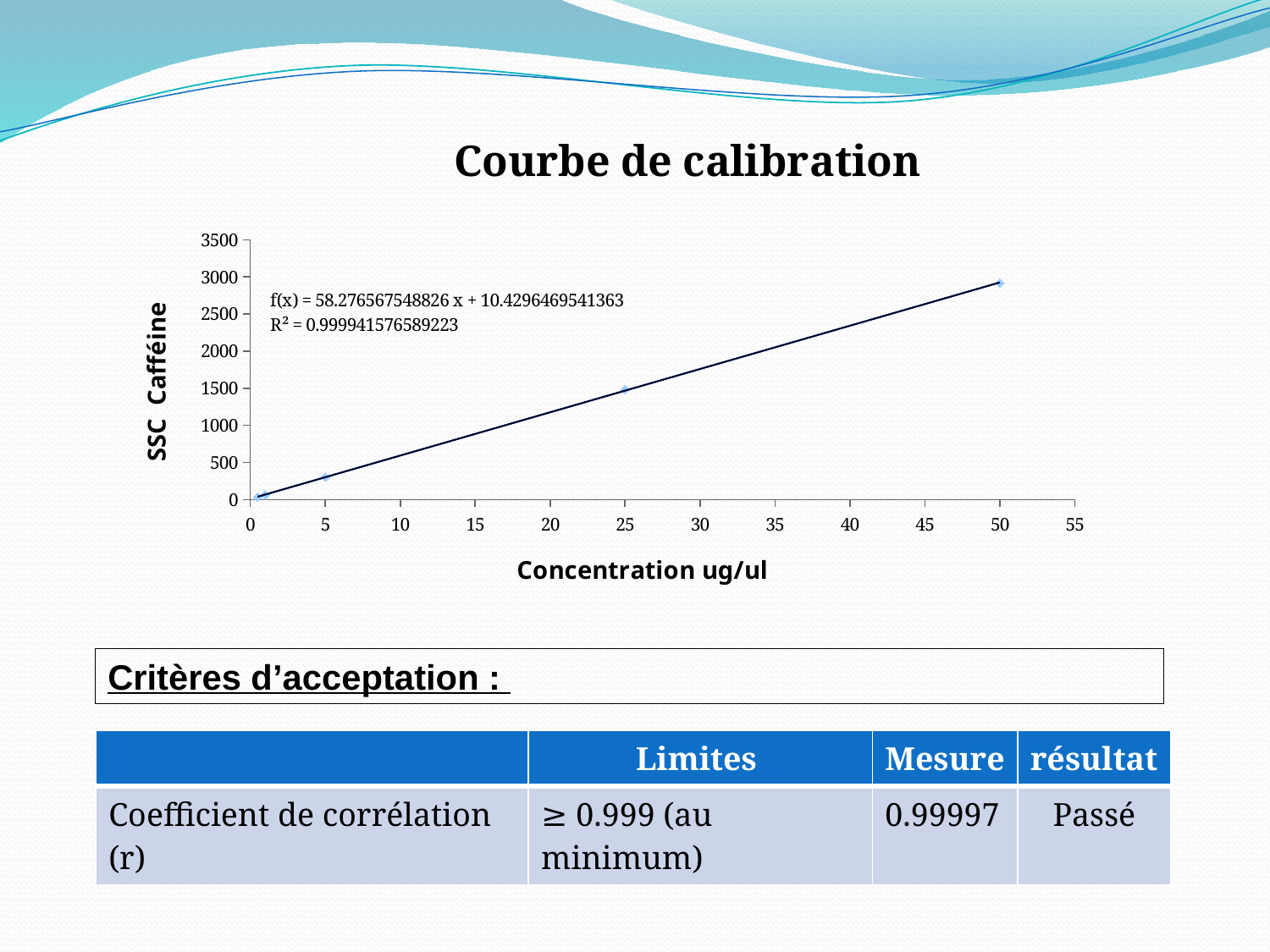
What kind of chart is shown on the slide? scatter chart What is the title of the chart? Courbe de calibration Which has the larger SSC Caféine value, the point at concentration 25 or the point at concentration 5? 25 Is the SSC Caféine value at a concentration of 50 greater or less than 2500? greater At which concentration is the SSC Caféine value highest? 50 Is the SSC Caféine value at a concentration of 25 greater or less than 2000? less What is the slope of the trendline equation printed on the chart? 58.276567548826 What R² value is printed on the chart for the trendline? 0.999941576589223 Is the SSC Caféine value at a concentration of 5 greater or less than 500? less What is the label of the x axis of the chart? Concentration ug/ul Do the SSC Caféine values rise or fall as the concentration increases along the x axis? rise